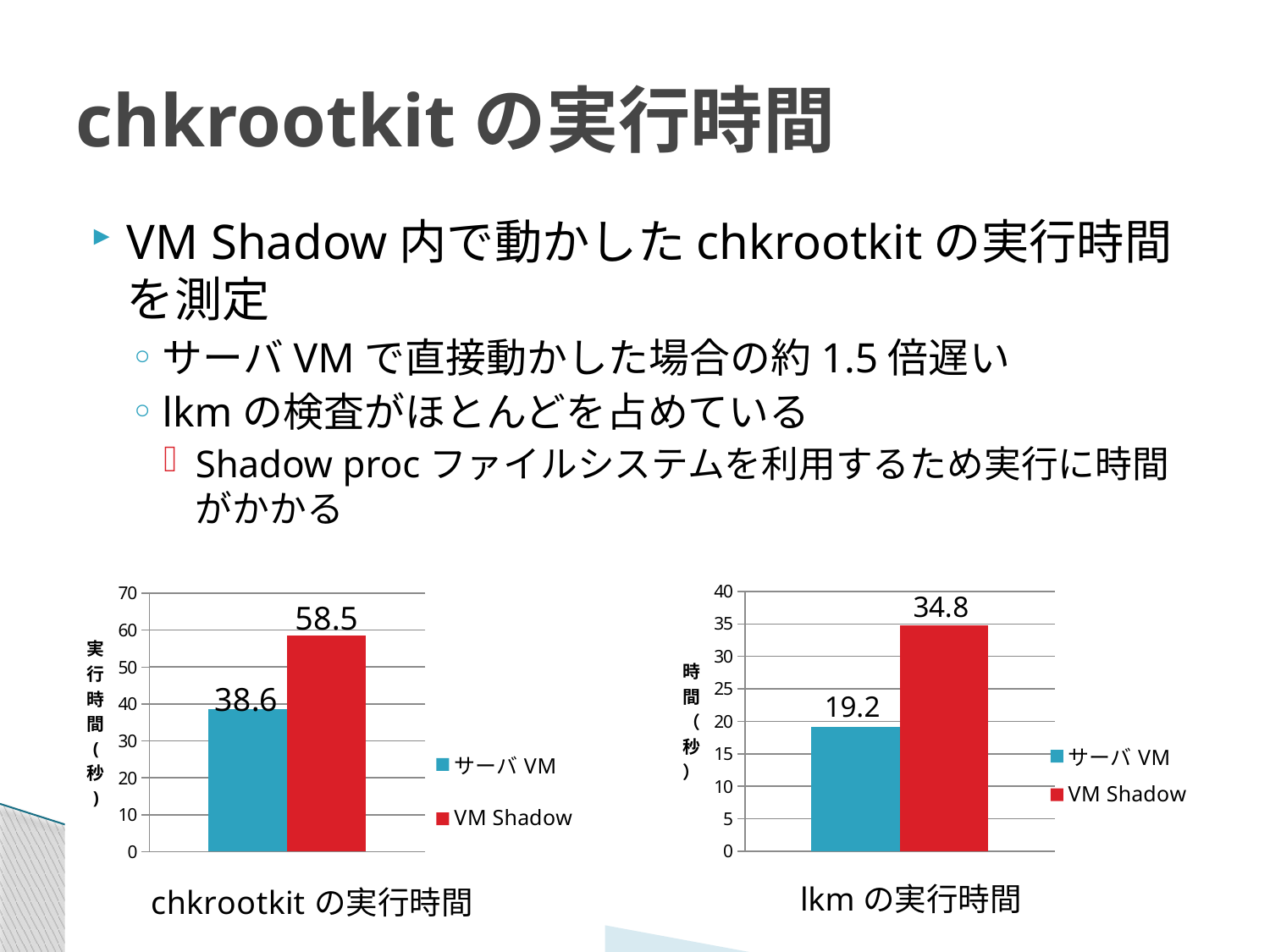
In the left chart (chkrootkit の実行時間), what is the difference between the VM Shadow and サーバ VM values? 19.9 In the right chart (lkm の実行時間), what is the value for サーバ VM? 19.2 What kind of chart is the right chart (lkm の実行時間)? bar chart In the left chart (chkrootkit の実行時間), which series has the higher value? VM Shadow In the left chart (chkrootkit の実行時間), what colour is the VM Shadow bar? red How many series does the legend of the left chart (chkrootkit の実行時間) list? 2 In the right chart (lkm の実行時間), what is the difference between the VM Shadow and サーバ VM values? 15.6 In the left chart (chkrootkit の実行時間), what is the value for VM Shadow? 58.5 In the right chart (lkm の実行時間), is the value for サーバ VM greater or less than 20? less In the right chart (lkm の実行時間), what is the value for VM Shadow? 34.8 In the right chart (lkm の実行時間), which series has the lower value? サーバ VM In the left chart (chkrootkit の実行時間), what is the value for サーバ VM? 38.6